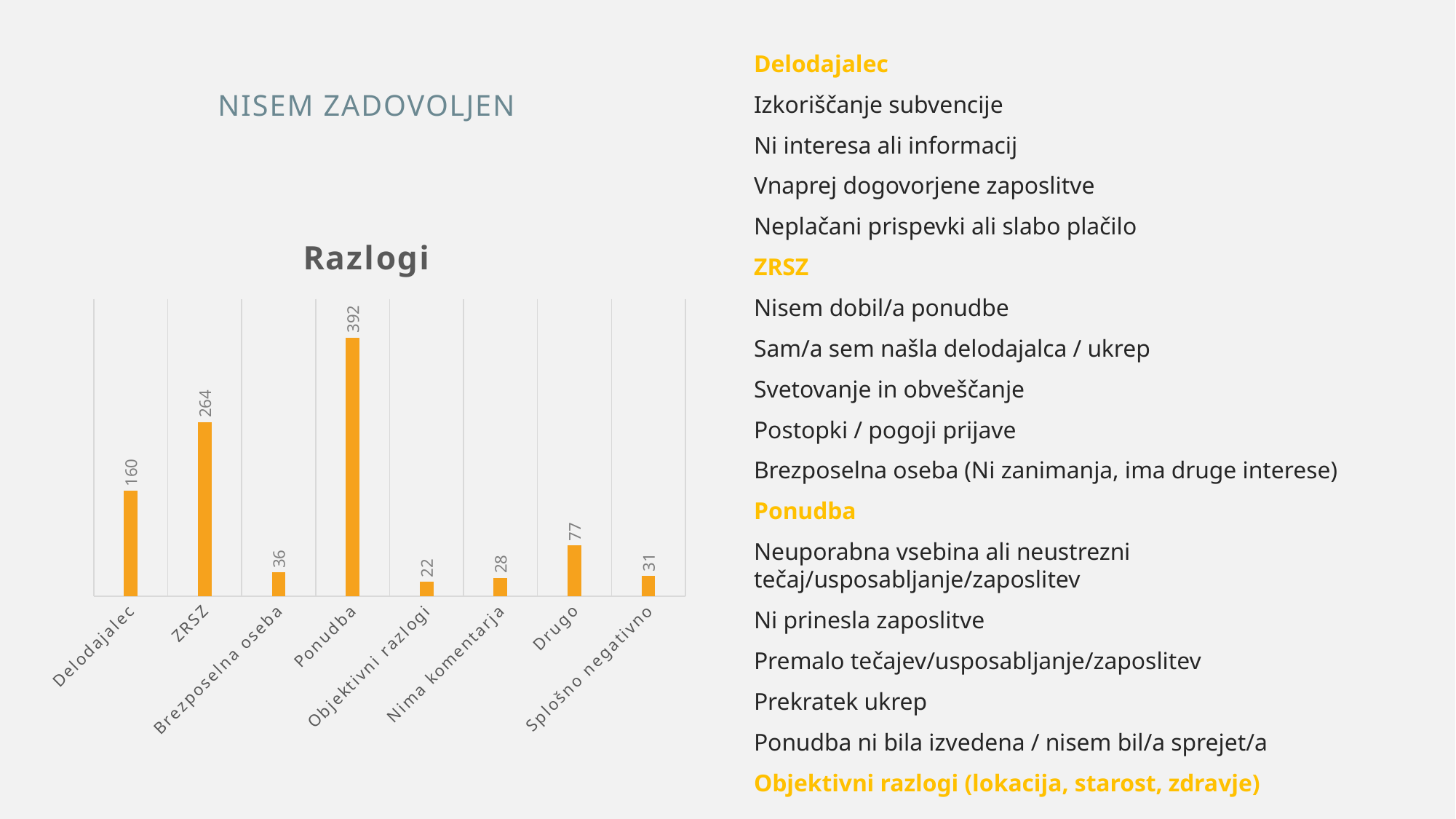
What is the title of the chart on the slide? Razlogi What kind of chart is the Razlogi chart? bar chart What is the value for Delodajalec in the Razlogi chart? 160 What is the value for Ponudba in the Razlogi chart? 392 What is the difference between the values for Drugo and Splošno negativno in the Razlogi chart? 46 What is the value for ZRSZ in the Razlogi chart? 264 Which category has the lowest value in the Razlogi chart? Objektivni razlogi What is the value for Drugo in the Razlogi chart? 77 Which is larger in the Razlogi chart, Brezposelna oseba or Nima komentarja? Brezposelna oseba Which category has the highest value in the Razlogi chart? Ponudba What is the difference between the values for Ponudba and ZRSZ in the Razlogi chart? 128 How many categories are shown in the Razlogi chart? 8